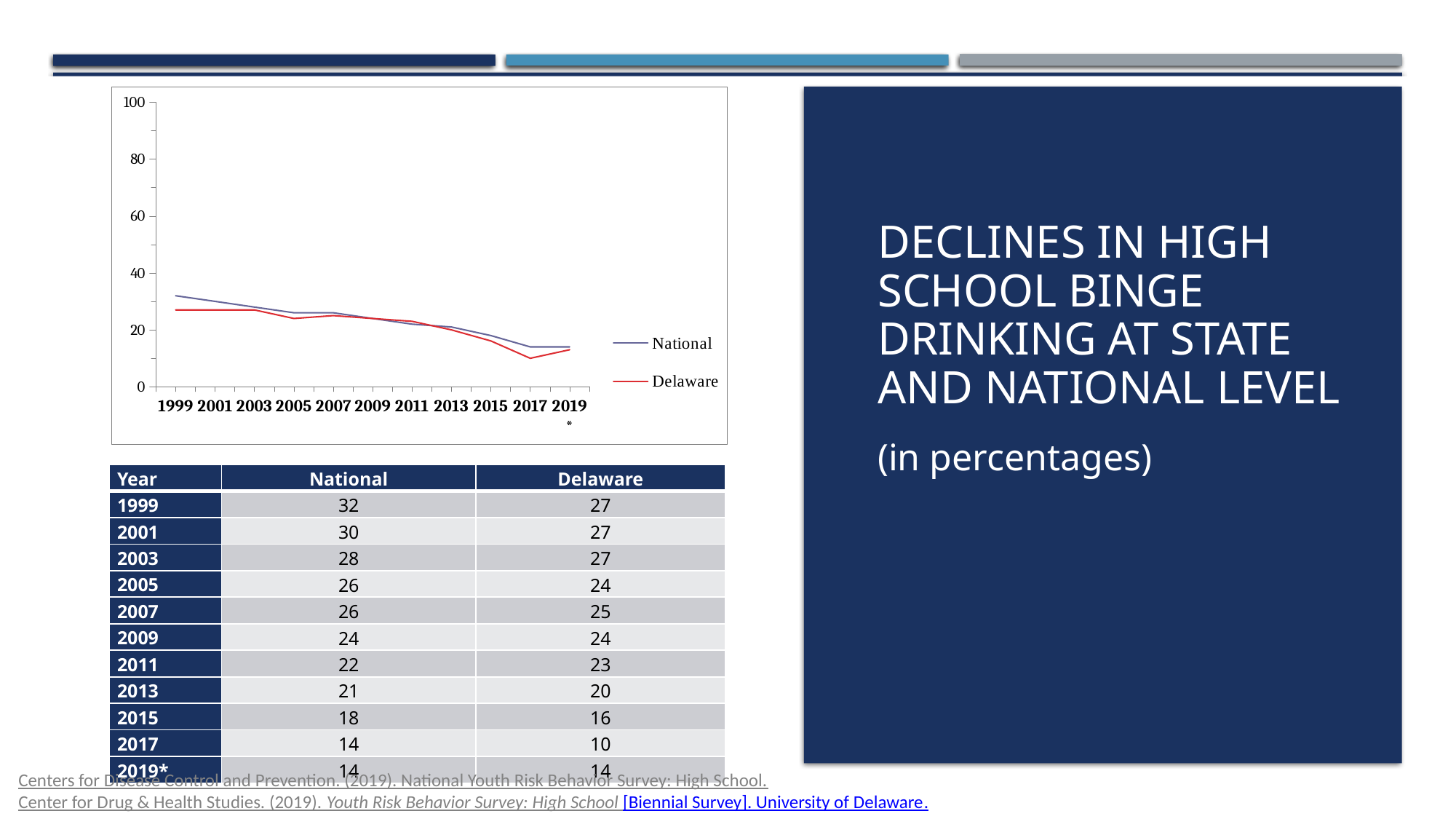
Do the National values rise or fall from 1999 to 2019? fall Which series has the larger value in 2017, National or Delaware? National What kind of chart is shown on the slide? line chart What colour is the Delaware line in the chart? red How many years are plotted along the x axis of the chart? 11 Is the National value for 2005 greater or less than 40? less In which year is the Delaware series at its lowest? 2017 In which year is the National series at its highest? 1999 What is the difference between the National and Delaware values in 1999? 5 What is the Delaware value for 2017? 10 How many series does the chart's legend list? 2 What is the National value for 1999? 32